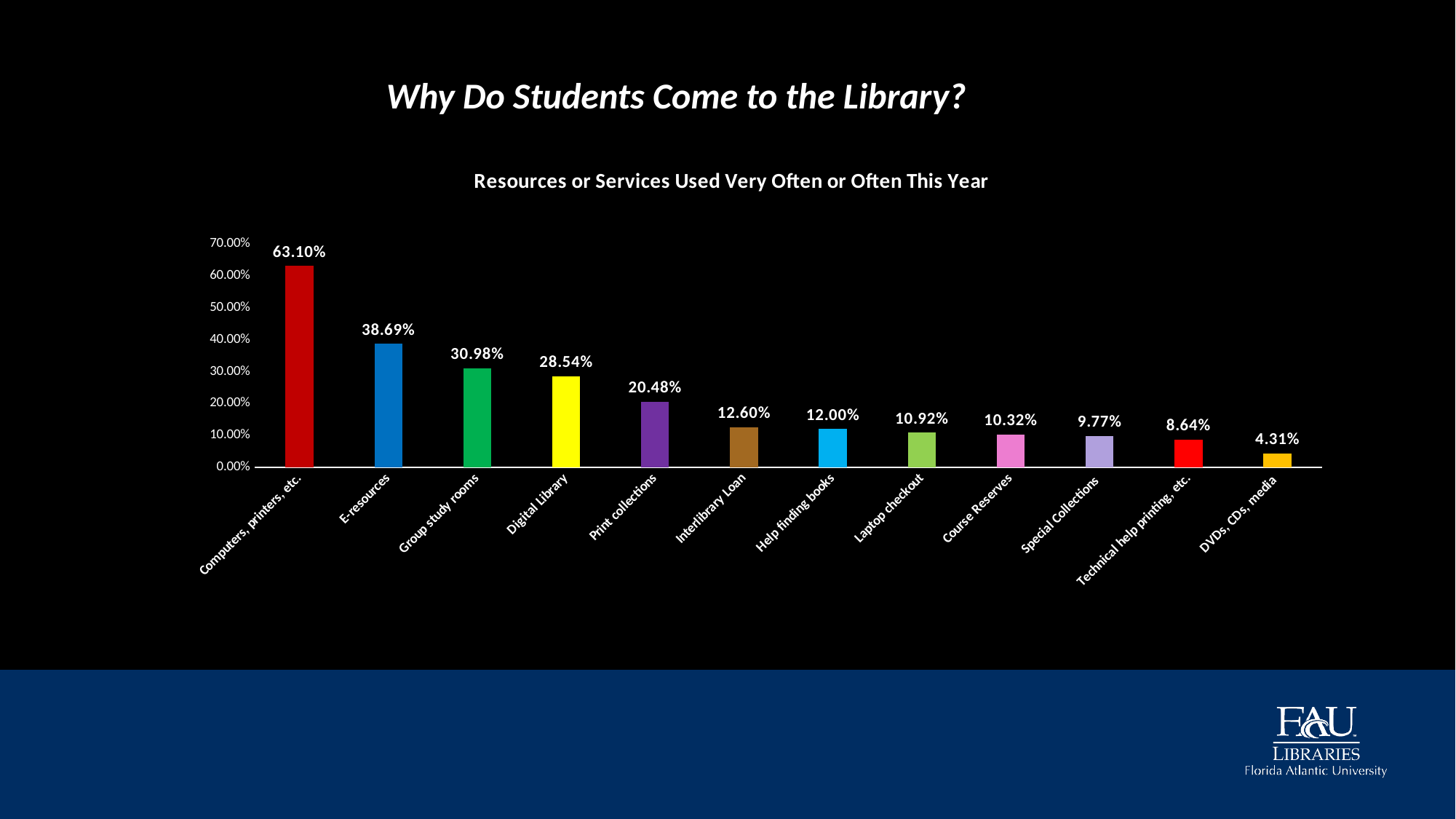
What is the value shown for Group study rooms? 30.98% Which is larger, the value for Print collections or the value for Interlibrary Loan? Print collections How many resources or services are shown on the chart? 12 Do the values rise or fall moving from left to right along the x axis? Fall Which resource or service has the highest percentage? Computers, printers, etc. What kind of chart is shown on the slide? Bar chart Which resource or service has the lowest percentage? DVDs, CDs, media What is the value shown for Course Reserves? 10.32% Is the value for Laptop checkout greater or less than 20.00%? less What is the difference between the values for E-resources and Digital Library? 10.15% What percentage of students used computers, printers, etc. very often or often this year? 63.10% What is the title of the chart? Resources or Services Used Very Often or Often This Year